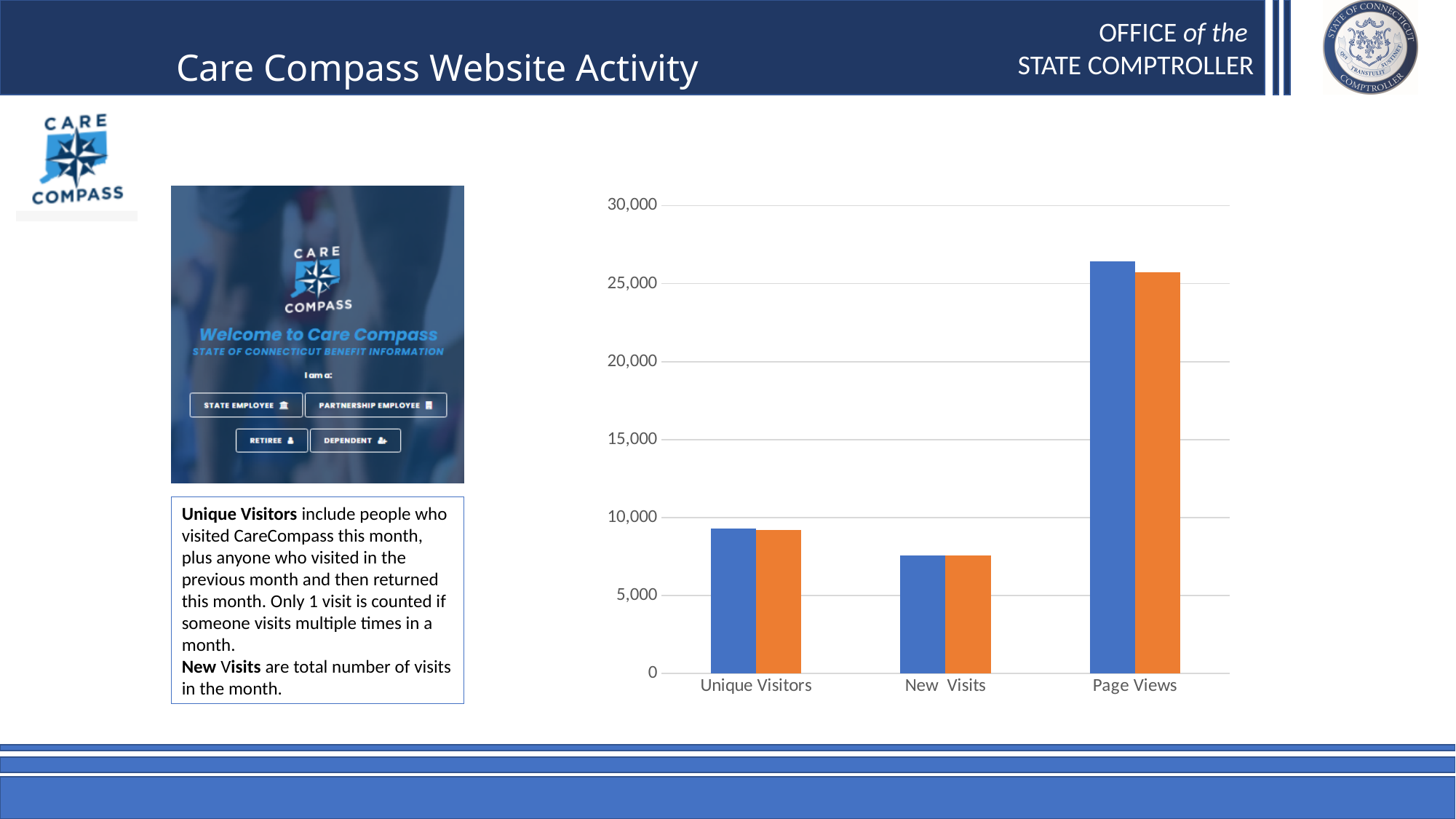
Is the value of the orange bar for Unique Visitors greater or less than 5,000? greater Which is larger, the orange bar for Page Views or the orange bar for Unique Visitors? Page Views Is the value of the blue bar for Unique Visitors greater or less than 10,000? less Is the value of the blue bar for New Visits greater or less than 5,000? greater Which category has the lowest bars in the chart? New Visits What is the highest value shown on the chart's vertical axis? 30,000 How many categories are shown on the x axis of the chart? 3 What kind of chart is shown on the slide? bar chart Which category has the highest bars in the chart? Page Views Which is larger, the blue bar for Unique Visitors or the blue bar for New Visits? Unique Visitors